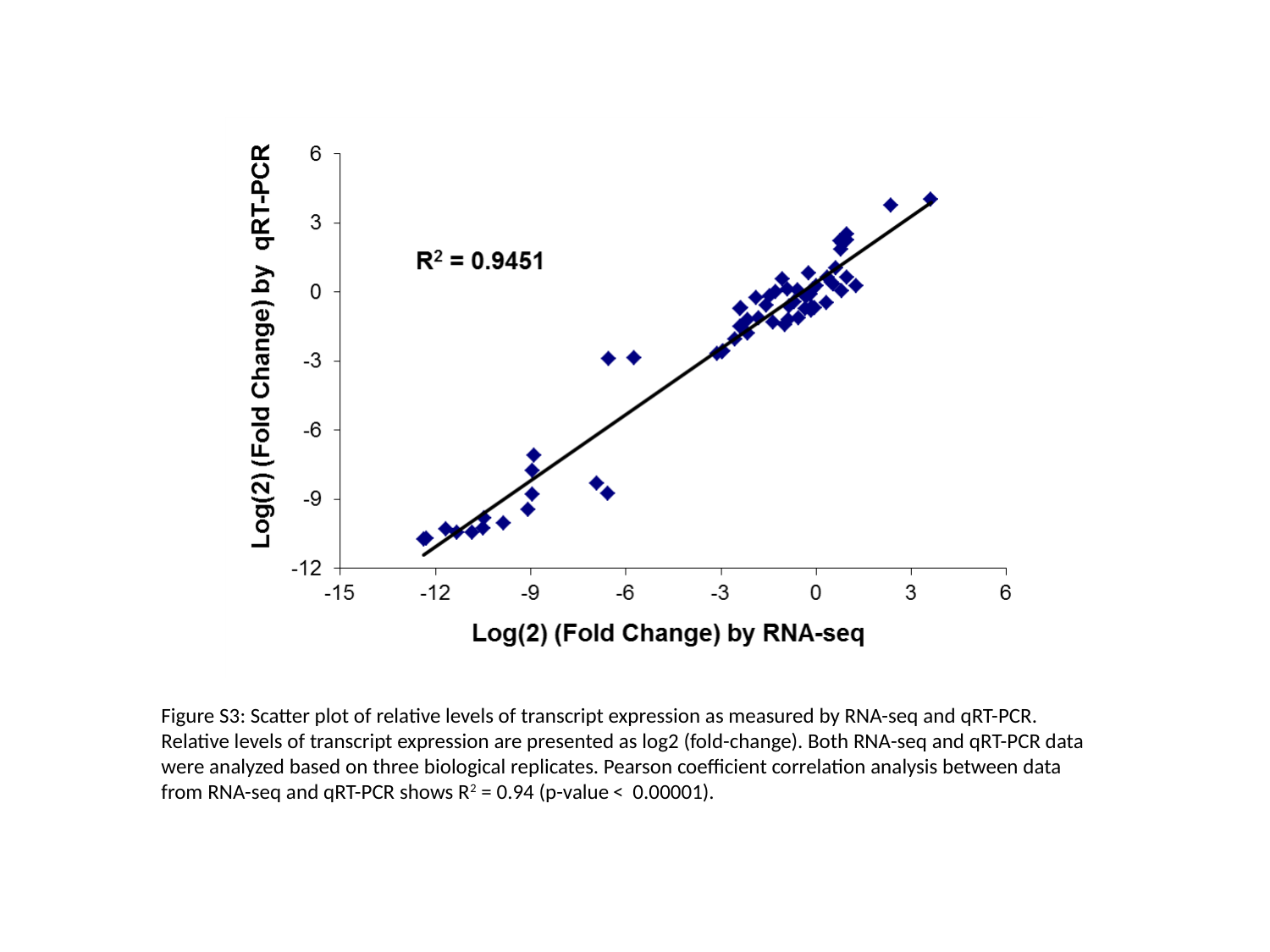
Is the R² value printed on the chart greater or less than 0.9? greater What is the lowest tick value shown on the y axis? -12 What is the highest tick value shown on the y axis? 6 Is the slope of the fitted trend line positive or negative? Positive What R² value is printed on the chart? R² = 0.9451 What is the lowest tick value shown on the x axis? -15 Do the plotted points rise or fall as the x-axis value increases? Rise What kind of chart is shown on the slide? Scatter plot What is the label of the x axis? Log(2) (Fold Change) by RNA-seq What is the label of the y axis? Log(2) (Fold Change) by qRT-PCR